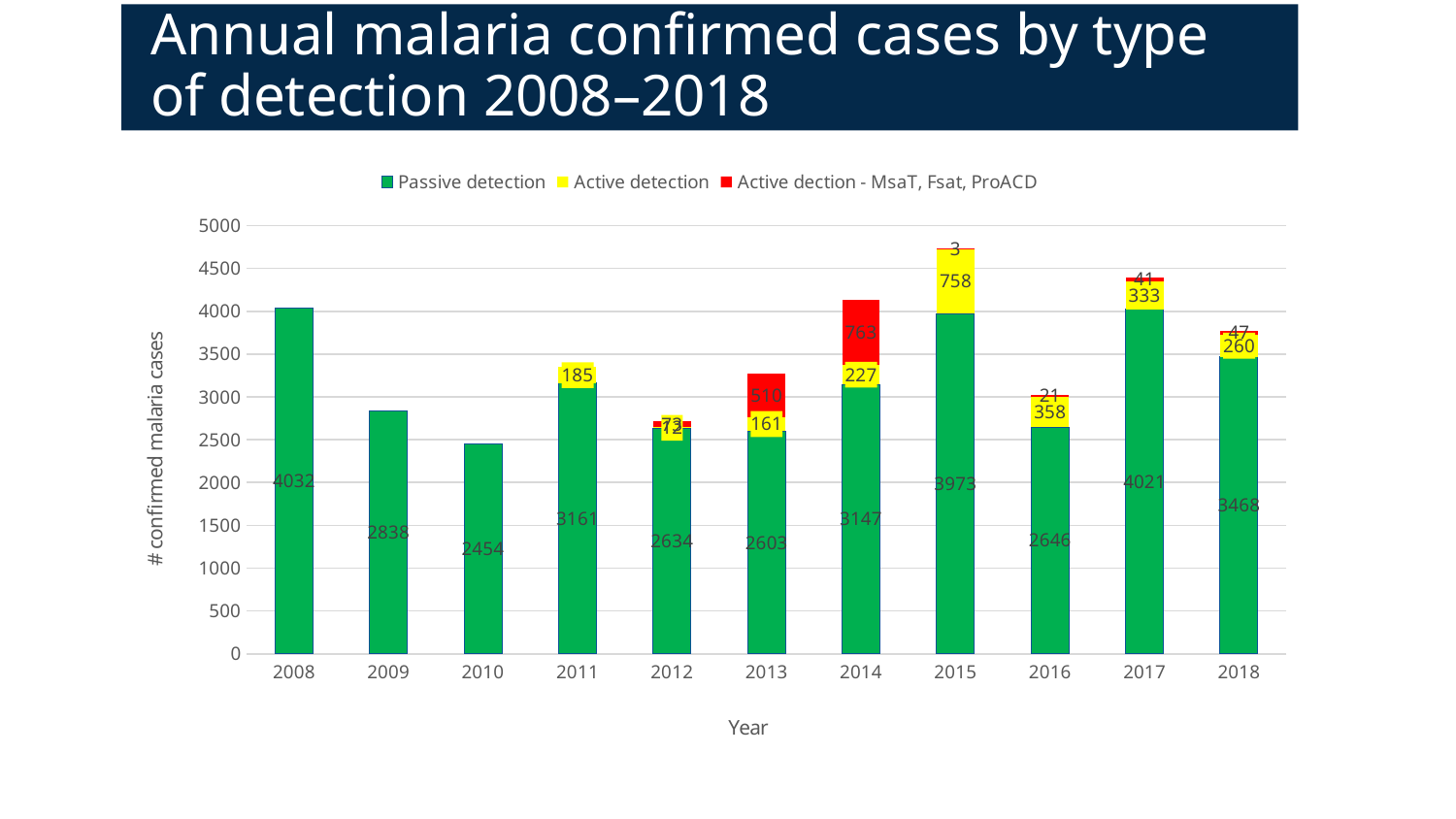
How many years are shown on the x axis? 11 What is the Active dection - MsaT, Fsat, ProACD value for 2014? 763 What is the Passive detection value for 2008? 4032 What is the total of the stacked bar for 2013? 3274 Which year has the highest Passive detection value? 2008 Which year has the lowest Passive detection value? 2010 What is the Active detection value for 2015? 758 Is the total height of the 2015 bar greater or less than 4500? greater What kind of chart is shown on the slide? Stacked bar chart How many series does the legend list? 3 Which year has the larger Passive detection value, 2011 or 2009? 2011 What is the difference between the Active dection - MsaT, Fsat, ProACD values for 2014 and 2013? 253